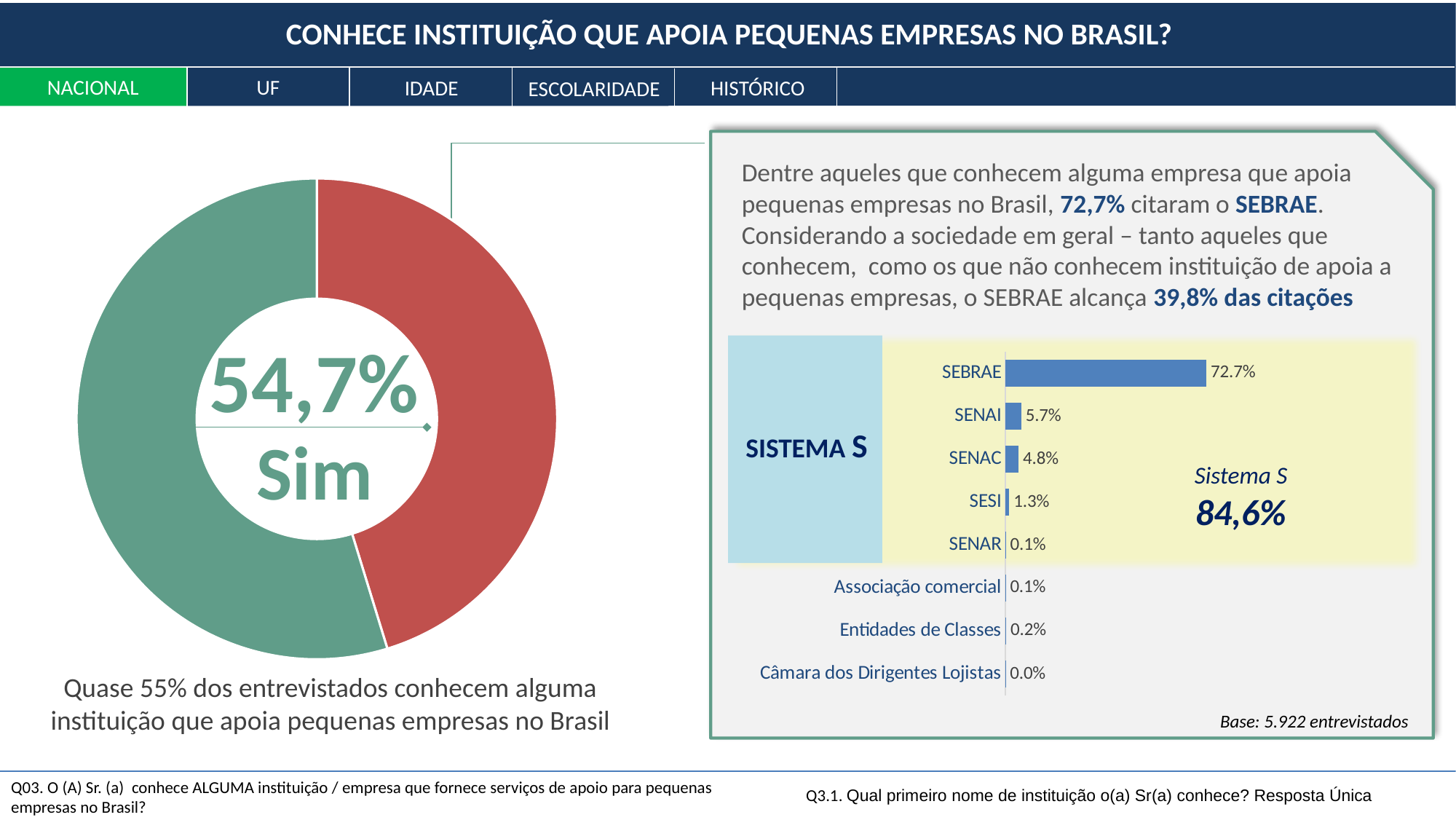
In the bar chart on the right, what is the difference between the values for SEBRAE and SENAI? 67.0% In the bar chart on the right, which institution has the lowest value? Câmara dos Dirigentes Lojistas In the donut chart on the left, what share of respondents answered "Sim"? 54,7% In the bar chart on the right, what is the value for SENAI? 5.7% In the bar chart on the right, which is larger, the value for SENAI or the value for SENAC? SENAI In the bar chart on the right, what is the value for SEBRAE? 72.7% How many institutions are listed in the bar chart on the right? 8 What kind of chart is shown on the right side of the slide? Bar chart In the bar chart on the right, which institution has the highest value? SEBRAE In the bar chart on the right, what is the value for SESI? 1.3% In the bar chart on the right, what is the value for Entidades de Classes? 0.2% What kind of chart is shown on the left side of the slide? Pie (donut) chart